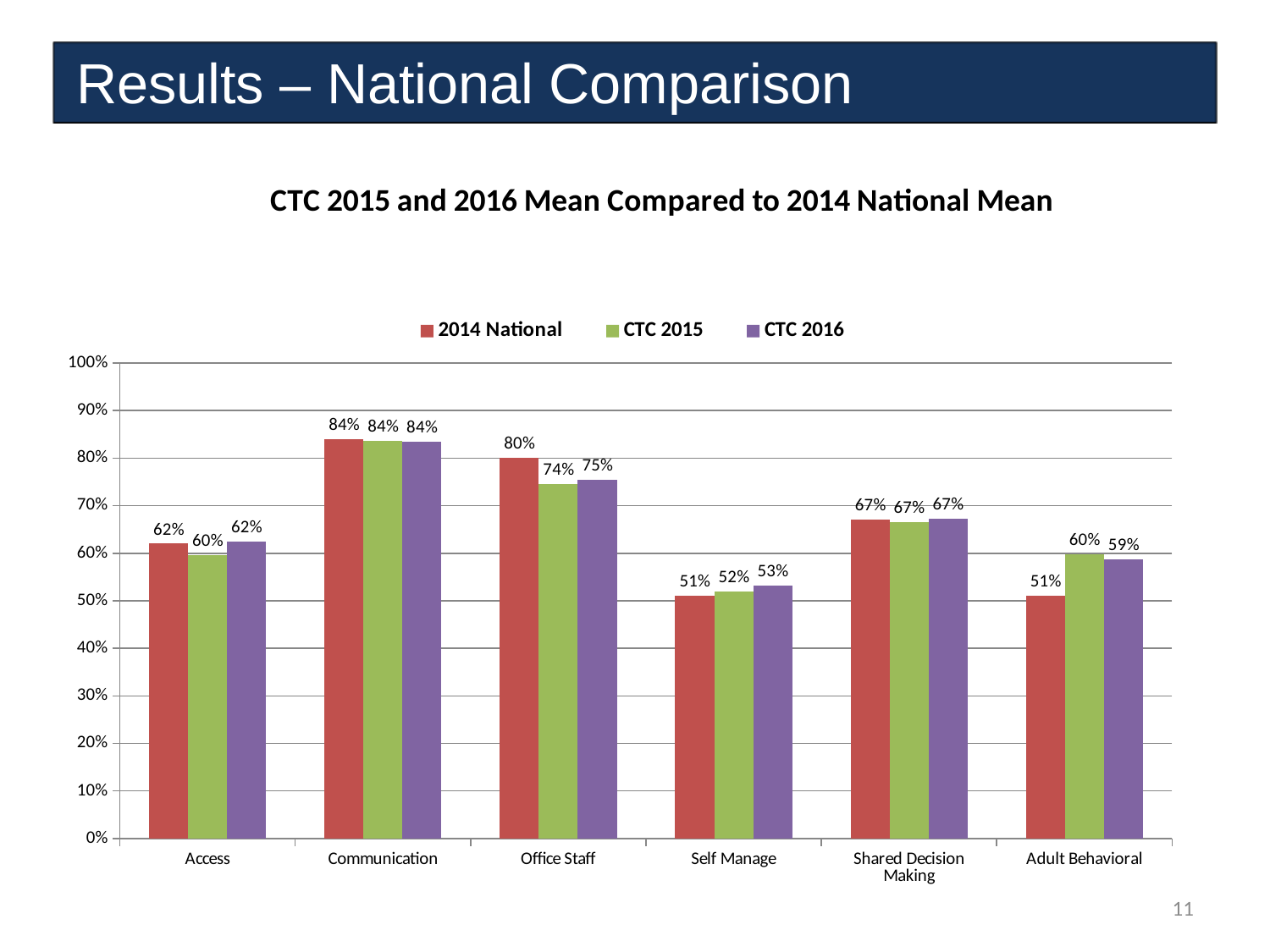
What kind of chart is shown on the slide? Bar chart How many categories are shown on the x axis? 6 What is the CTC 2015 value for Adult Behavioral? 60% What is the CTC 2016 value for Self Manage? 53% What is the title of the chart? CTC 2015 and 2016 Mean Compared to 2014 National Mean Which category has the highest CTC 2016 value? Communication What is the difference between the 2014 National value and the CTC 2015 value for Office Staff? 6% Is the CTC 2015 value for Shared Decision Making greater or less than 50%? greater For Adult Behavioral, which is larger: the 2014 National value or the CTC 2016 value? CTC 2016 Which category has the lowest 2014 National value? Self Manage and Adult Behavioral (both 51%) What is the 2014 National value for Office Staff? 80% How many series does the legend list? 3